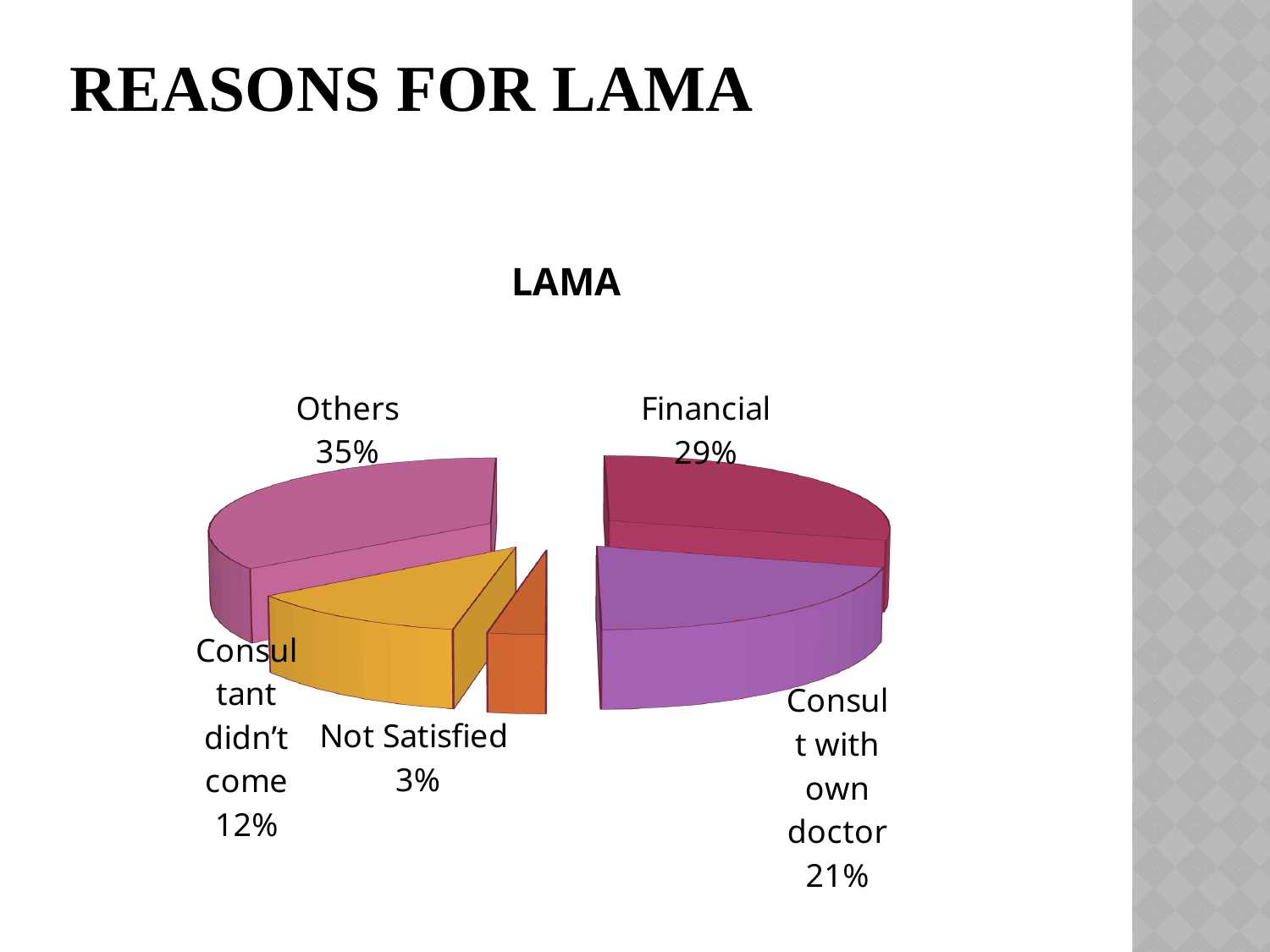
Which reason has the largest share of the pie? Others What percentage is shown for Consult with own doctor? 21% What is the chart's title? LAMA What percentage is shown for Consultant didn't come? 12% What percentage is shown for Not Satisfied? 3% What kind of chart is shown on the slide? Pie chart Which is larger, the share for Financial or the share for Consultant didn't come? Financial What share of the pie is labelled Others? 35% Which reason has the smallest share of the pie? Not Satisfied What is the difference in percentage points between Financial and Consult with own doctor? 8 What percentage of LAMA cases is attributed to Financial reasons? 29% How many slices does the pie chart have? 5